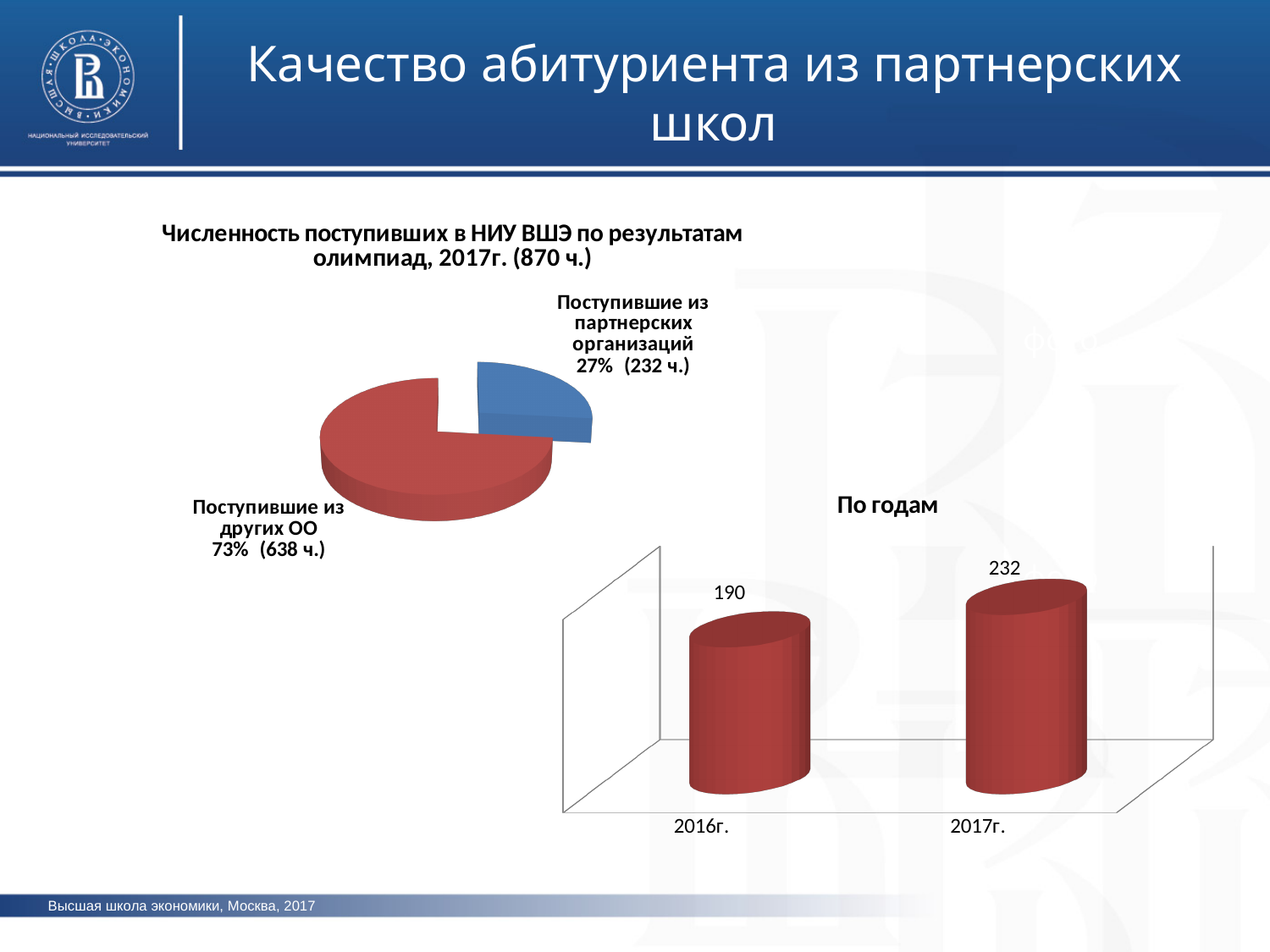
In the chart 'По годам', what is the value for 2017г.? 232 In the chart 'По годам', what is the difference between the 2017г. and 2016г. values? 42 In the pie chart 'Численность поступивших в НИУ ВШЭ по результатам олимпиад, 2017г. (870 ч.)', how many people are labelled for 'Поступившие из других ОО'? 638 ч. In the chart 'По годам', which year has the higher value? 2017г. In the pie chart 'Численность поступивших в НИУ ВШЭ по результатам олимпиад, 2017г. (870 ч.)', what is the difference in people between 'Поступившие из других ОО' and 'Поступившие из партнерских организаций'? 406 ч. What kind of chart is the chart on the left of the slide? Pie chart In the pie chart 'Численность поступивших в НИУ ВШЭ по результатам олимпиад, 2017г. (870 ч.)', what share is labelled for 'Поступившие из партнерских организаций'? 27% In the chart 'По годам', do the values rise or fall from 2016г. to 2017г.? Rise In the pie chart 'Численность поступивших в НИУ ВШЭ по результатам олимпиад, 2017г. (870 ч.)', how many slices are there? 2 In the chart 'По годам', what is the value for 2016г.? 190 What kind of chart is the chart titled 'По годам'? Bar chart In the pie chart 'Численность поступивших в НИУ ВШЭ по результатам олимпиад, 2017г. (870 ч.)', which slice is the largest? Поступившие из других ОО